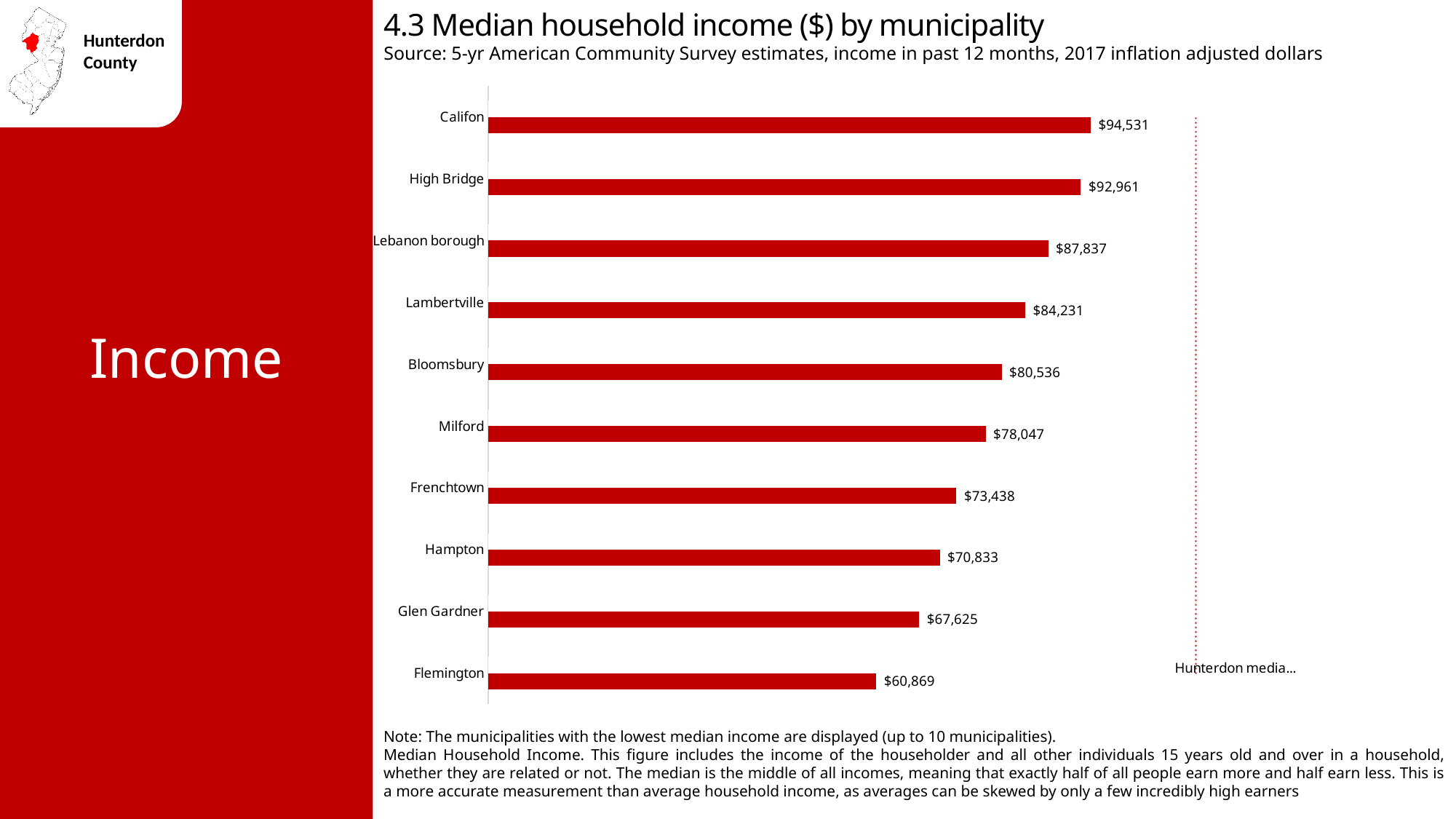
What is the median household income for Flemington? $60,869 What is the median household income for Lambertville? $84,231 How many municipalities are shown on the chart? 10 Which municipality has the lowest median household income shown on the chart? Flemington Which municipality has the highest median household income shown on the chart? Califon Which has a higher median household income, Milford or Frenchtown? Milford Do the median household income values increase or decrease going from Califon at the top to Flemington at the bottom? Decrease What type of chart is used to show median household income by municipality? Bar chart What is the difference in median household income between Hampton and Glen Gardner? $3,208 What does the dotted vertical line on the chart represent? Hunterdon median What is the median household income for Califon? $94,531 What is the difference in median household income between Califon and High Bridge? $1,570